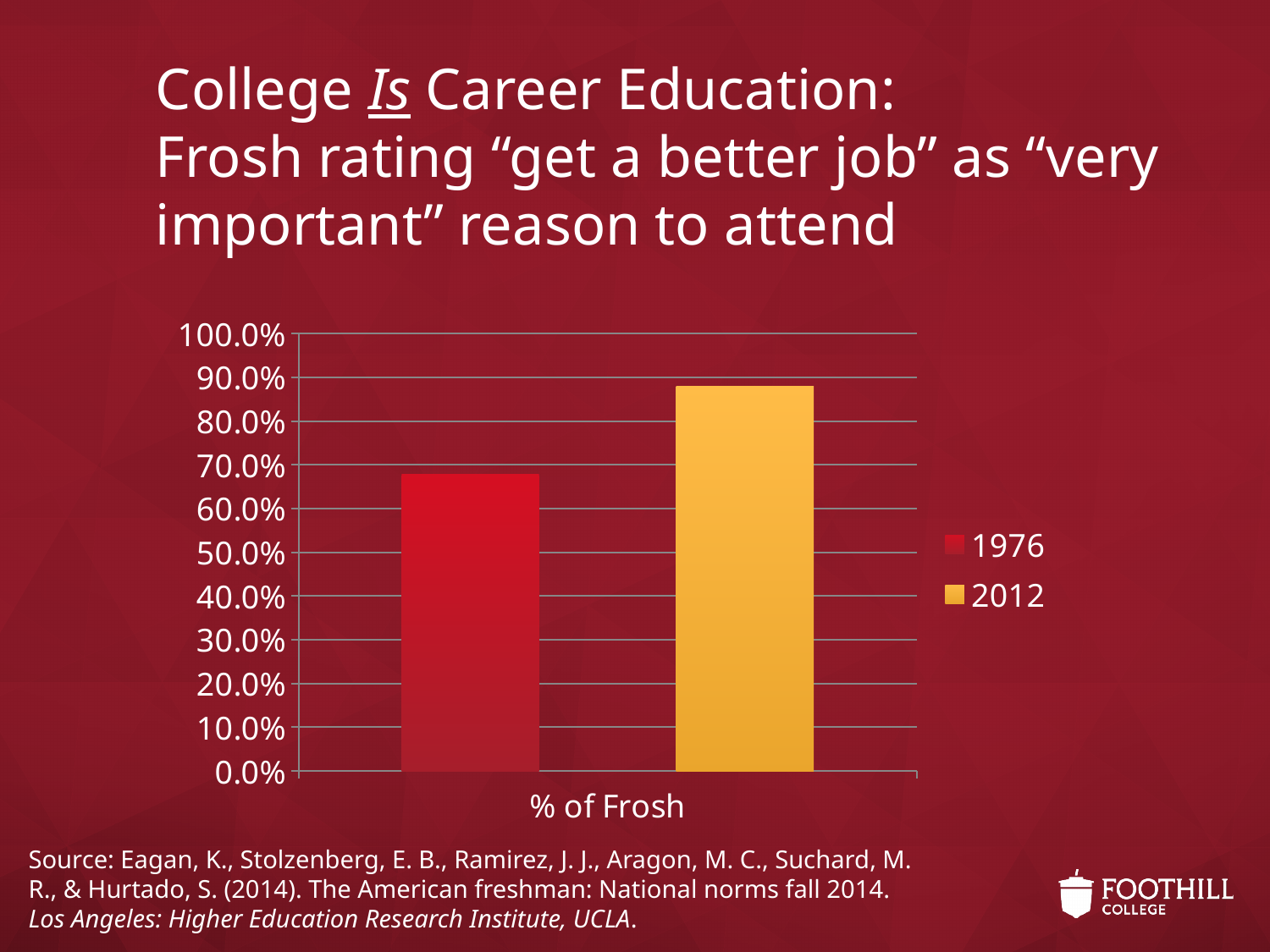
Is the value for 2012 greater or less than 90.0%? less Is the value for 1976 greater or less than 70.0%? less What kind of chart is shown on the slide? bar chart Is the value for 2012 greater or less than 80.0%? greater How many categories are shown on the x axis? 1 Which series has the highest bar? 2012 Which series has the lowest bar? 1976 Which series has the higher value for % of Frosh, 1976 or 2012? 2012 What is the label on the x axis of the chart? % of Frosh Which colour represents the 2012 series in the legend? yellow How many series does the legend list? 2